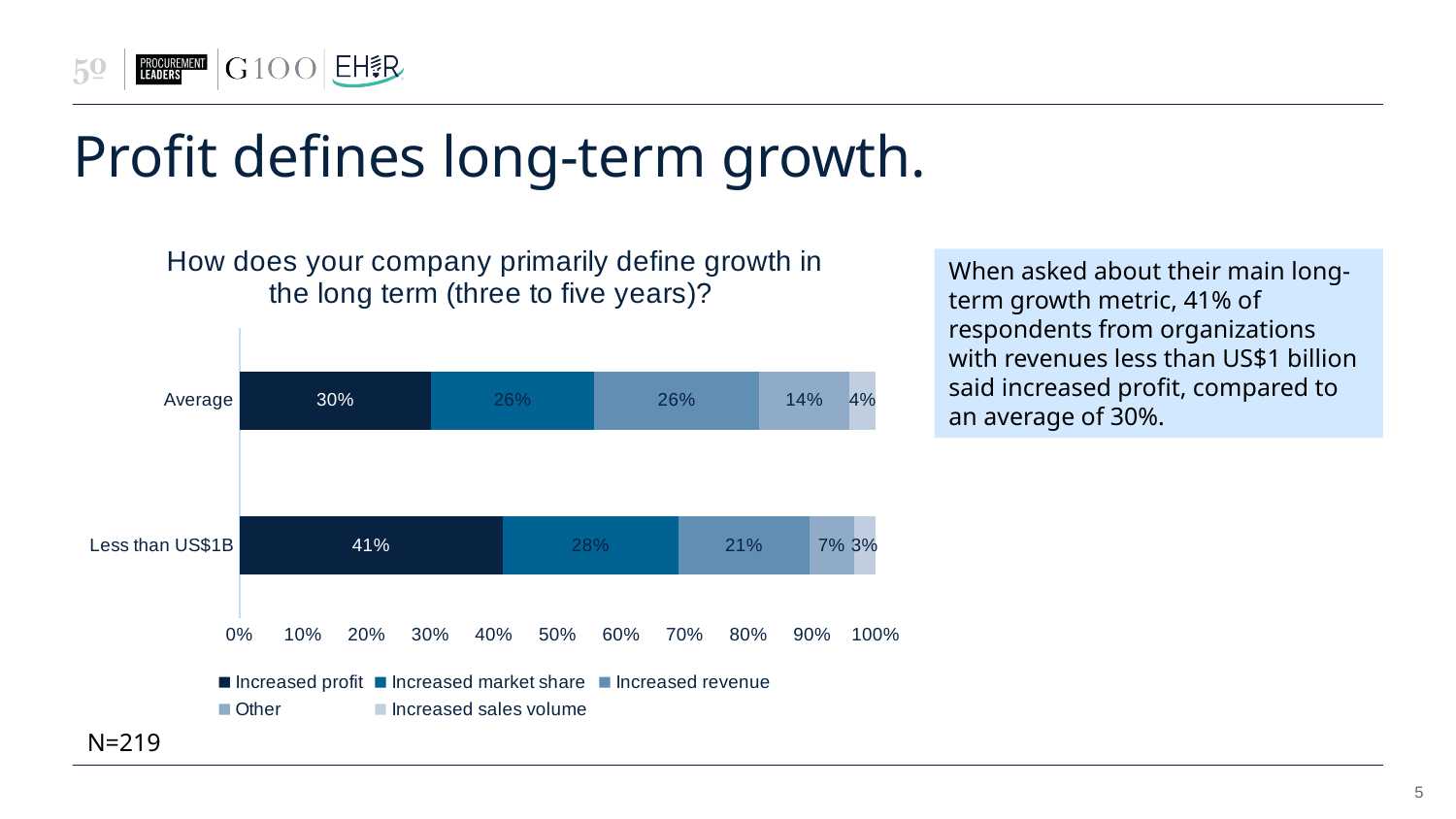
What is the value for Increased revenue in the Average category? 26% What is the value for Increased sales volume in the Average category? 4% What is the value for Increased market share in the Less than US$1B category? 28% What is the difference between the Increased profit values for Less than US$1B and Average? 11% What kind of chart is shown on the slide? Stacked bar chart What is the value for Other in the Less than US$1B category? 7% Which category has the larger value for Increased revenue, Average or Less than US$1B? Average How many categories are plotted on the chart? 2 What is the title of the chart? How does your company primarily define growth in the long term (three to five years)? What is the value for Increased profit in the Average category? 30% What is the value for Increased profit in the Less than US$1B category? 41% How many series does the legend list? 5